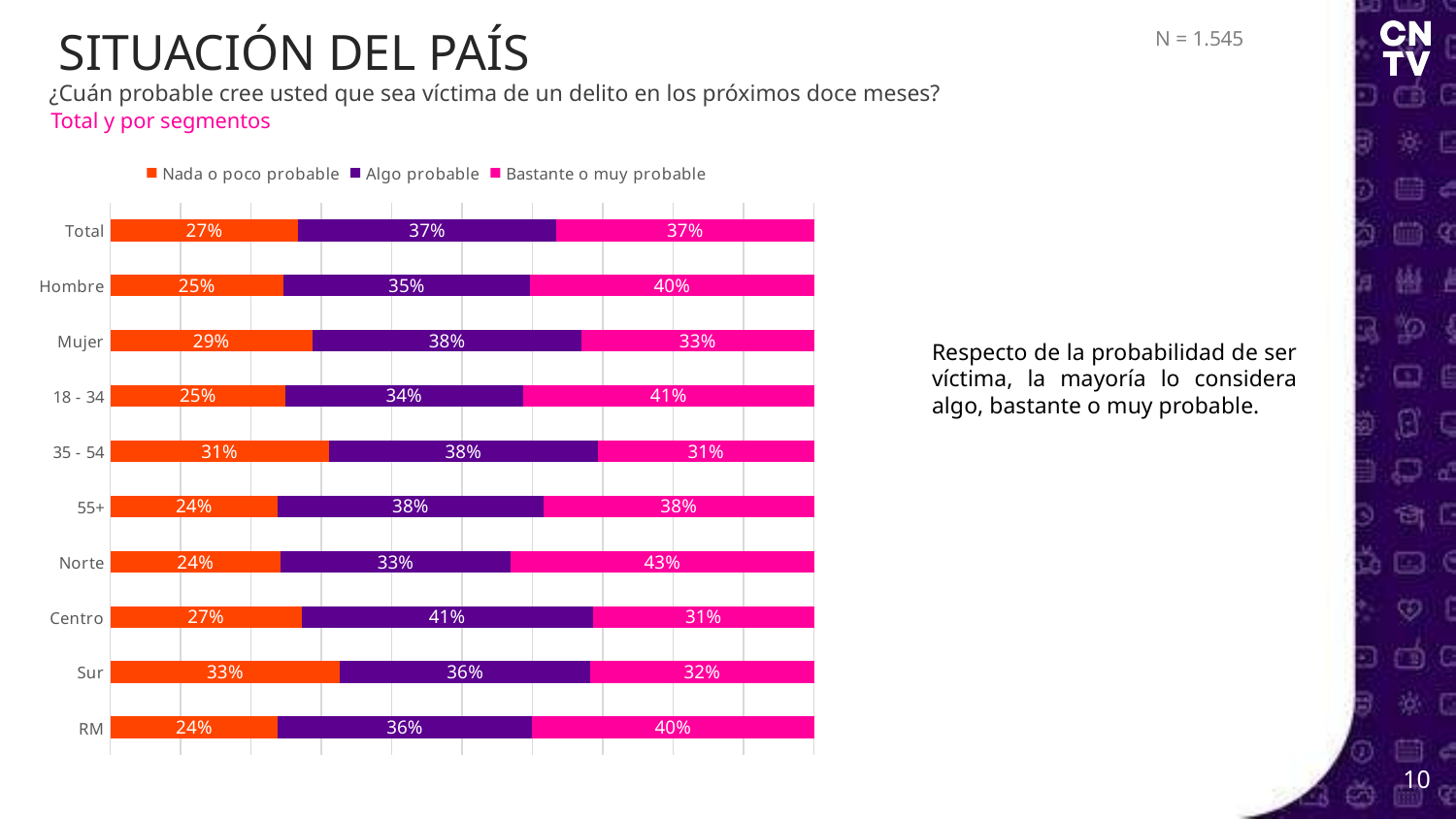
What is the combined value of 'Nada o poco probable' and 'Algo probable' for the Total category? 64% What kind of chart is shown on the slide? Stacked horizontal bar chart How many series does the legend list? 3 What is the value for 'Nada o poco probable' in the Sur category? 33% What is the value for 'Bastante o muy probable' in the Norte category? 43% Which category has the highest value for 'Bastante o muy probable'? Norte Which legend entry is shown in orange? Nada o poco probable Which is larger: the 'Algo probable' value for 18 - 34 or for 35 - 54? 35 - 54 What is the difference between the 'Bastante o muy probable' values for Hombre and Mujer? 7 percentage points Which category has the lowest value for 'Nada o poco probable'? 55+, Norte and RM (24%) What is the value for 'Algo probable' in the Centro category? 41% How many categories are shown on the y axis of the chart? 10